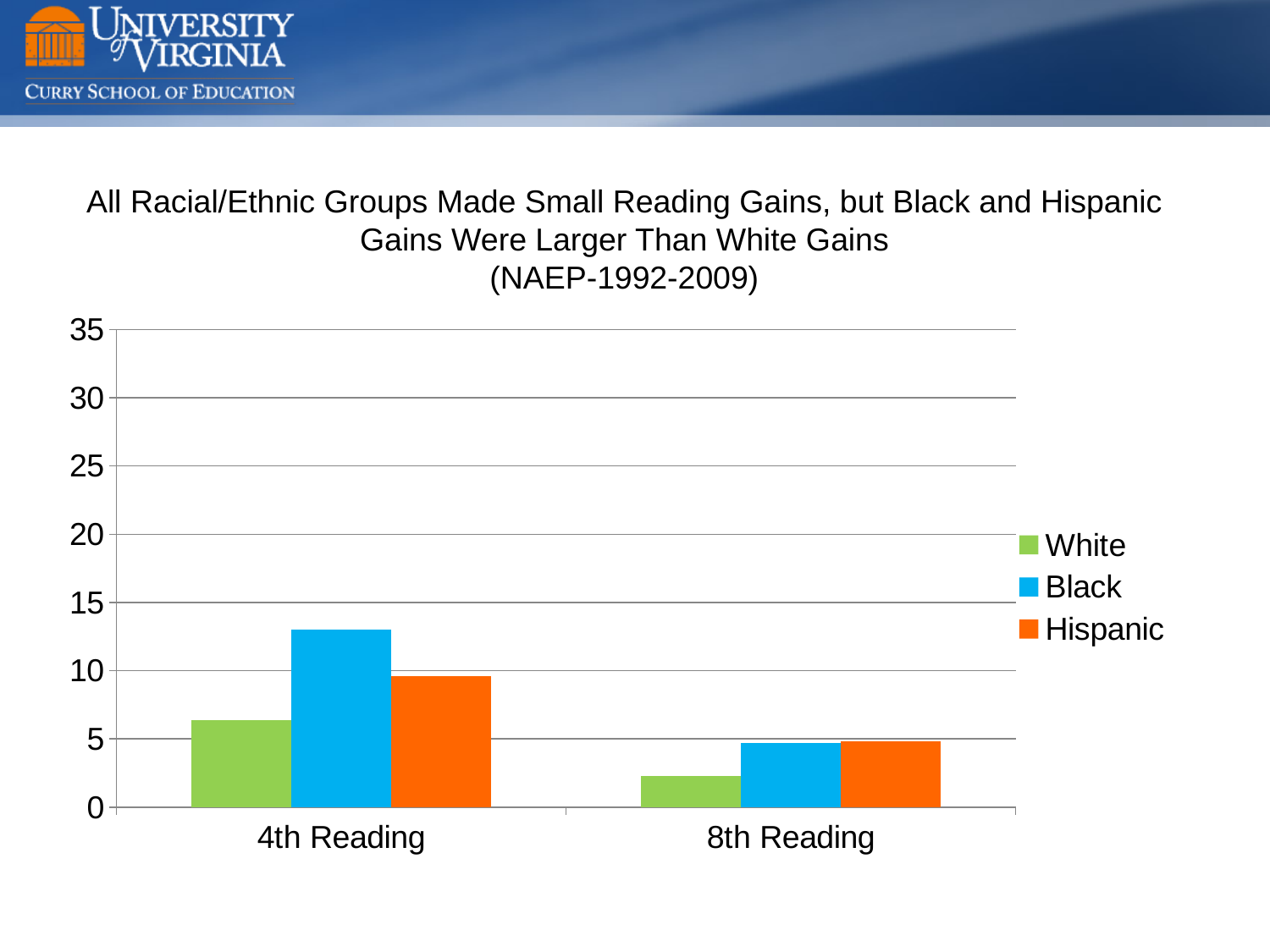
Is the White value for 4th Reading greater or less than 5? greater Which colour represents Hispanic in the legend? orange What kind of chart is shown on the slide? bar chart Which group has the lowest value for 4th Reading? White For 4th Reading, which is larger, the Black value or the Hispanic value? Black Do the values for each group rise or fall from 4th Reading to 8th Reading? fall How many categories are shown on the x axis? 2 Which group has the lowest value for 8th Reading? White Is the Black value for 4th Reading greater or less than 10? greater How many series does the legend list? 3 Which group has the highest value for 4th Reading? Black Is the White value for 8th Reading greater or less than 5? less